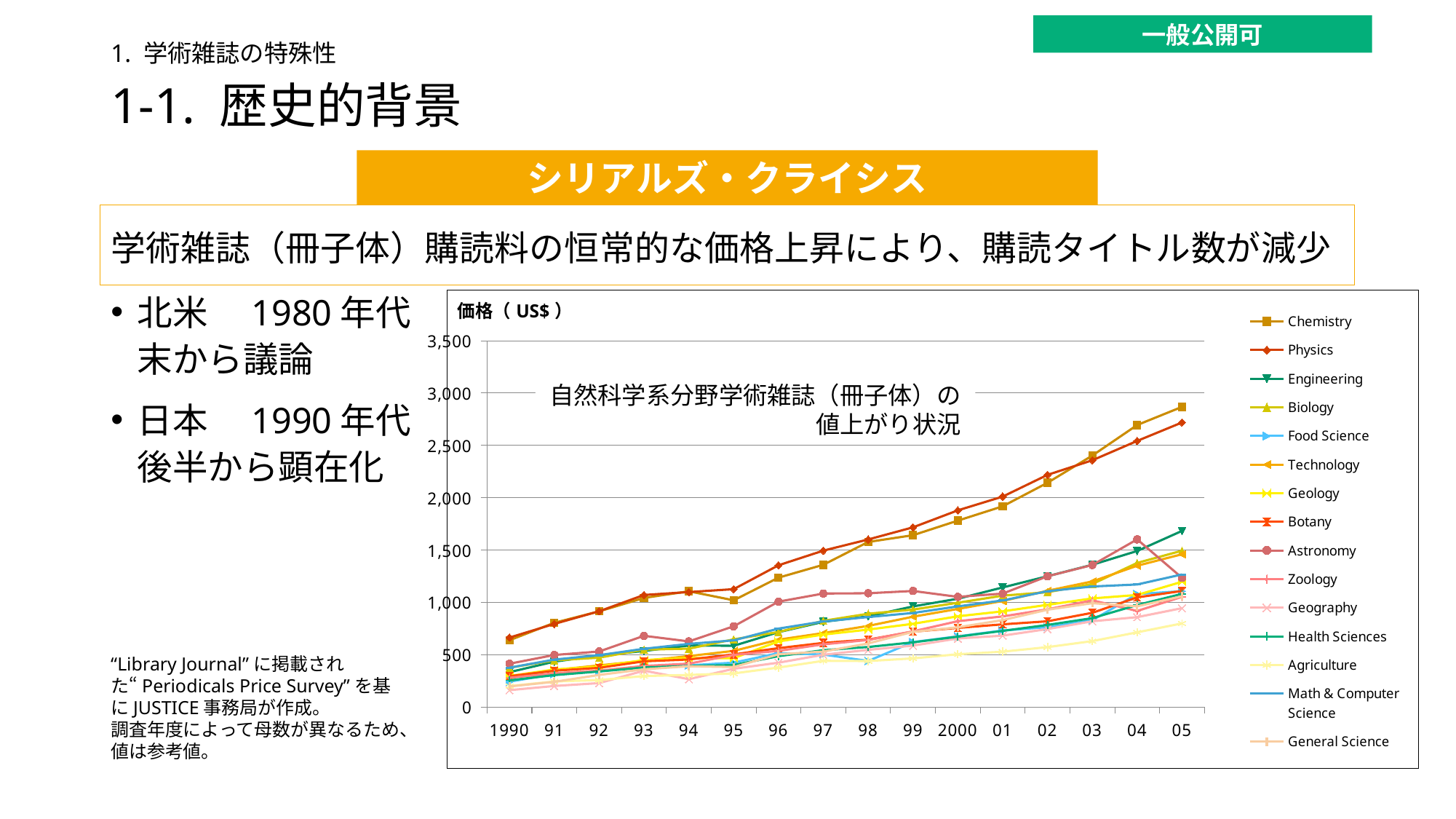
Which series has the highest value in 05? Chemistry Is the value for Agriculture in 05 greater or less than 1,000? less Which series has the lowest value in 05? Agriculture How many series does the chart's legend list? 15 Is the value for Engineering in 05 greater or less than 1,500? greater What kind of chart is shown on the slide? Line chart How many years are plotted along the x axis of the chart? 16 Is the value for Geography in 1990 greater or less than 500? less Which is larger in 05, the value for Physics or the value for Astronomy? Physics What is the title shown inside the chart? 自然科学系分野学術雑誌（冊子体）の値上がり状況 Does the Chemistry series rise or fall from 1990 to 05? Rise